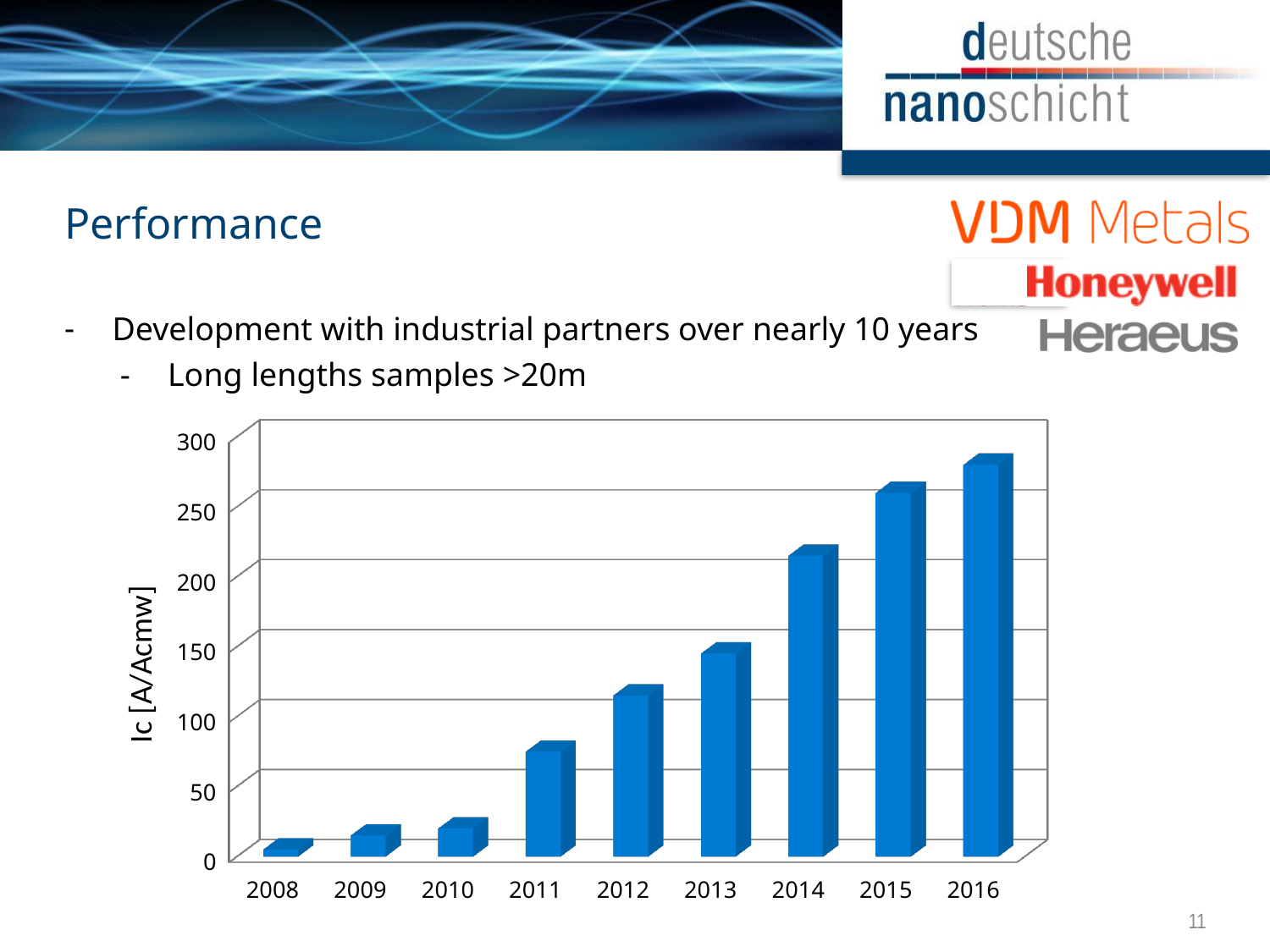
How many years are shown on the x axis of the chart? 9 Which year has the highest Ic value in the chart? 2016 Which year has the lowest Ic value in the chart? 2008 Do the Ic values rise or fall from 2008 to 2016? rise Which year has a larger Ic value, 2012 or 2014? 2014 What kind of chart is shown on the slide? bar chart Is the Ic value for 2011 greater or less than 50? greater What is the label on the y axis of the chart? Ic [A/Acmw] Is the Ic value for 2012 greater or less than 100? greater Is the Ic value for 2016 greater or less than 250? greater